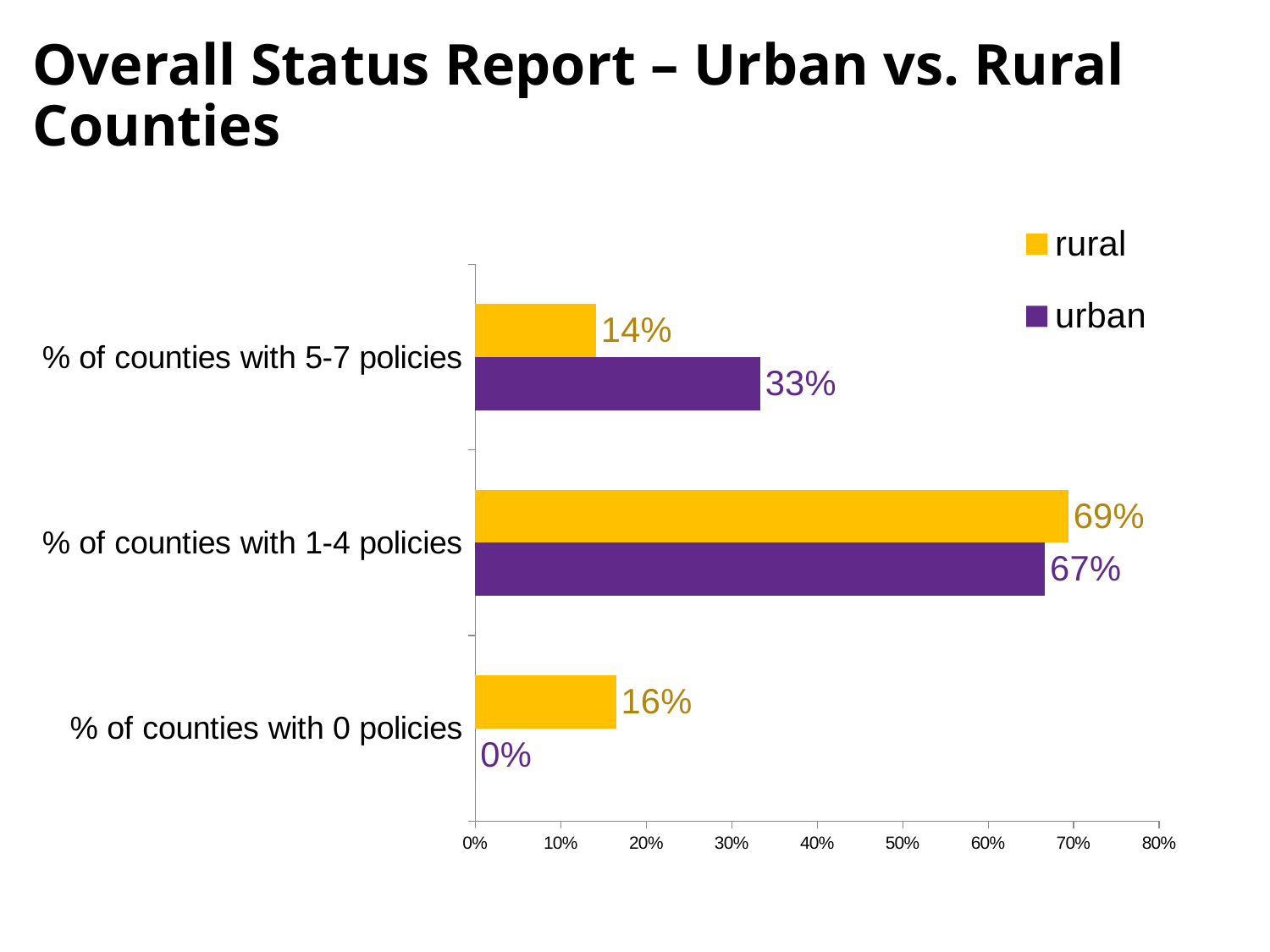
What is the rural value for % of counties with 1-4 policies? 69% How many categories are shown on the chart? 3 What kind of chart is shown on the slide? bar chart What is the rural value for % of counties with 5-7 policies? 14% Which category has the highest rural value? % of counties with 1-4 policies What is the urban value for % of counties with 5-7 policies? 33% Which colour represents the urban series? purple Which category has the lowest urban value? % of counties with 0 policies What is the difference between the urban and rural values for % of counties with 5-7 policies? 19% What is the urban value for % of counties with 0 policies? 0% For % of counties with 0 policies, which is larger, the rural or the urban value? rural How many series does the legend list? 2